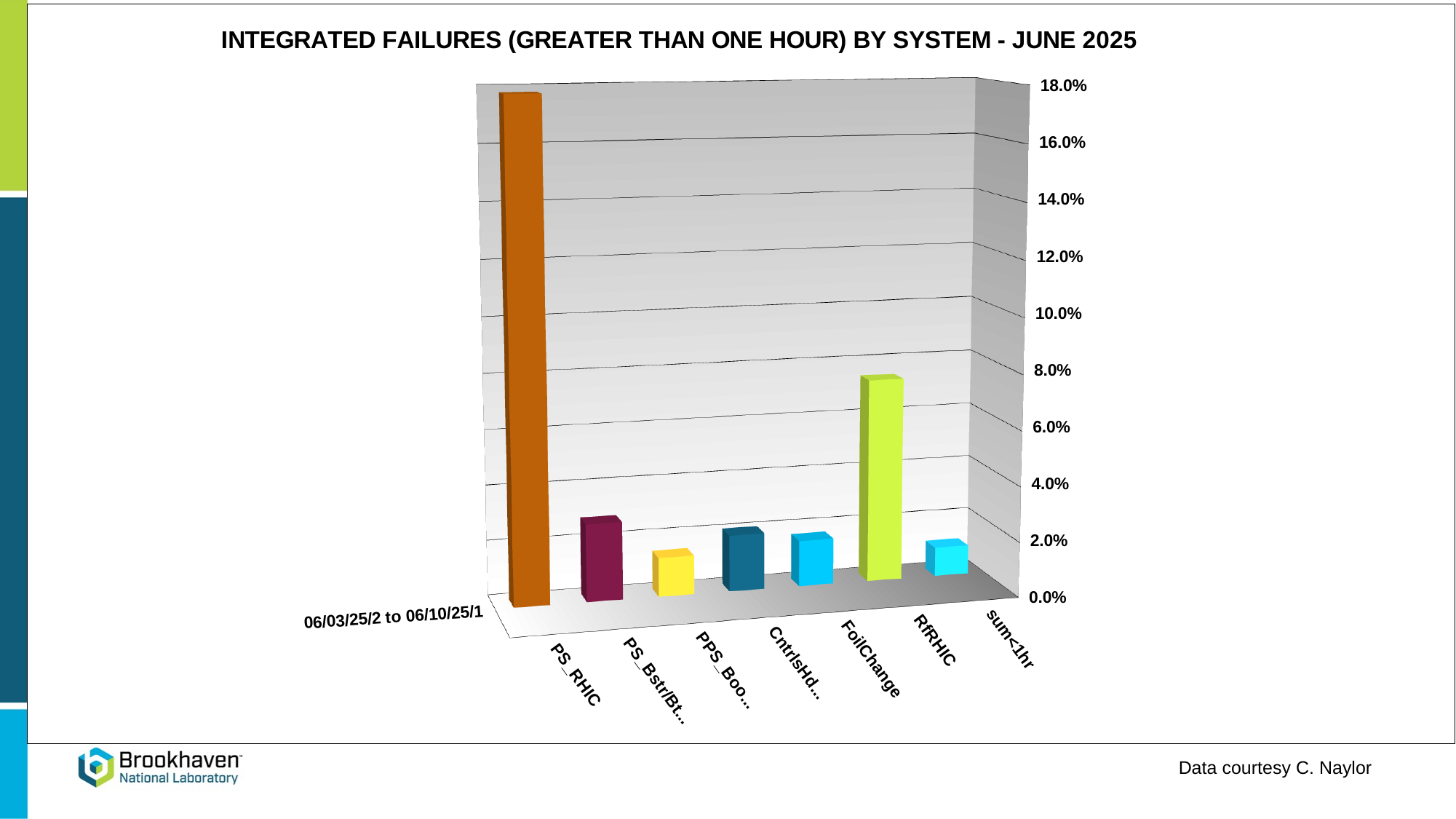
Is the value for PS_RHIC greater or less than 16.0%? greater What is the maximum value shown on the vertical axis? 18.0% What is the label of the first category on the x axis? PS_RHIC Is the value for PS_Bstr/Bt... greater or less than 4.0%? less Which is larger, the value for PS_RHIC or the value for FoilChange? PS_RHIC Is the value for PS_RHIC greater or less than 10.0%? greater What is the title of the chart? INTEGRATED FAILURES (GREATER THAN ONE HOUR) BY SYSTEM - JUNE 2025 Which system has the highest integrated failure percentage? PS_RHIC How many system categories are plotted on the x axis? 7 Which is larger, the value for PS_RHIC or the value for RfRHIC? PS_RHIC What type of chart is shown on the slide? bar chart